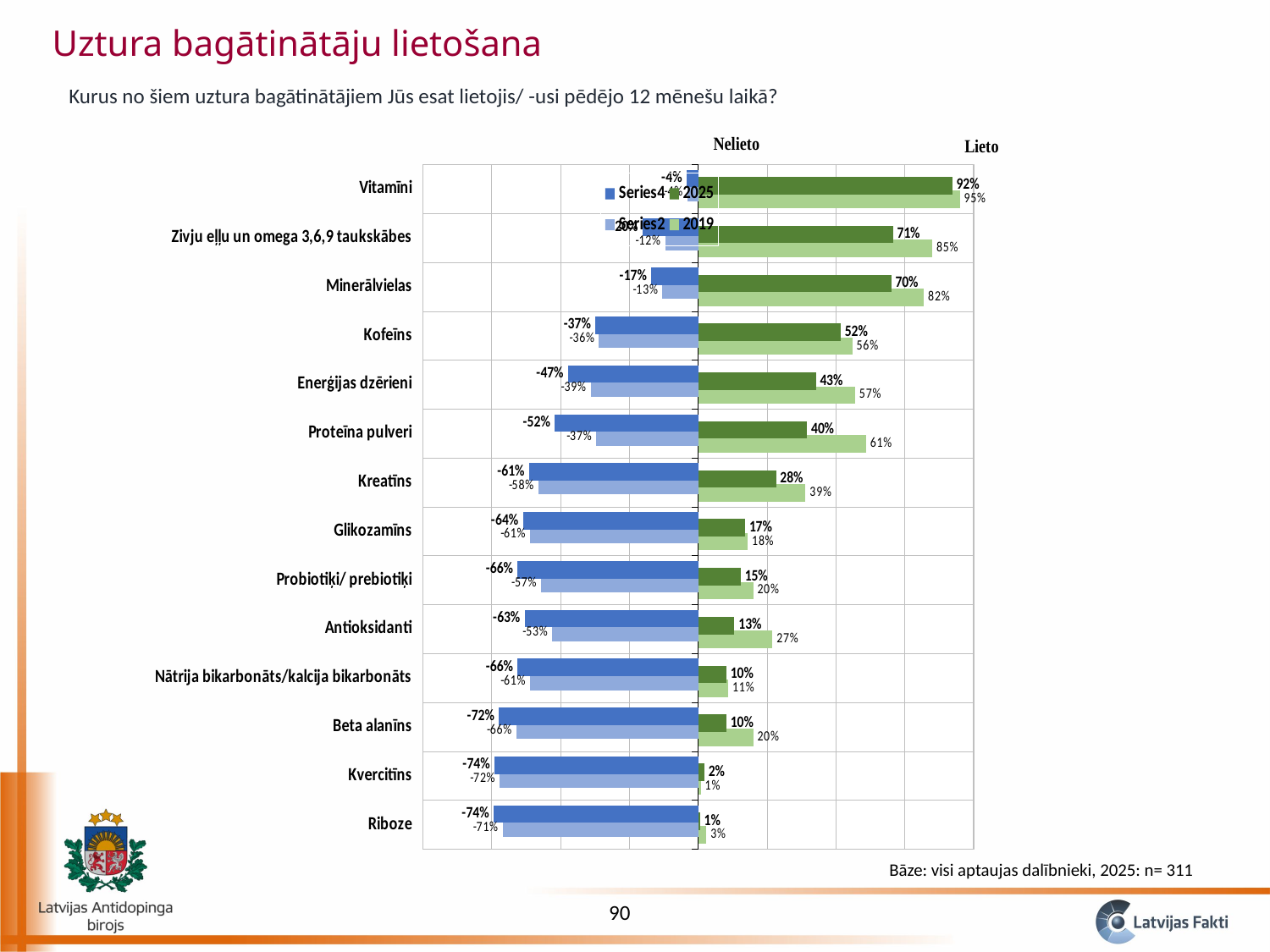
What is the 2025 'Nelieto' value for Kofeīns? -37% What is the 2025 'Lieto' value for Antioksidanti? 13% What is the 2019 'Lieto' value for Zivju eļļu un omega 3,6,9 taukskābes? 85% How many supplement categories are listed on the chart? 14 Which has a larger 2025 'Lieto' value, Kofeīns or Enerģijas dzērieni? Kofeīns Which category has the lowest 2025 'Lieto' value? Riboze What kind of chart is shown on the slide? bar chart What is the 2025 'Lieto' value for Vitamīni? 92% Which category has the highest 2025 'Lieto' value? Vitamīni What is the difference between the 2019 and 2025 'Lieto' values for Proteīna pulveri? 21 percentage points What is the 2019 'Lieto' value for Proteīna pulveri? 61% What are the two column headings shown above the chart? Nelieto and Lieto